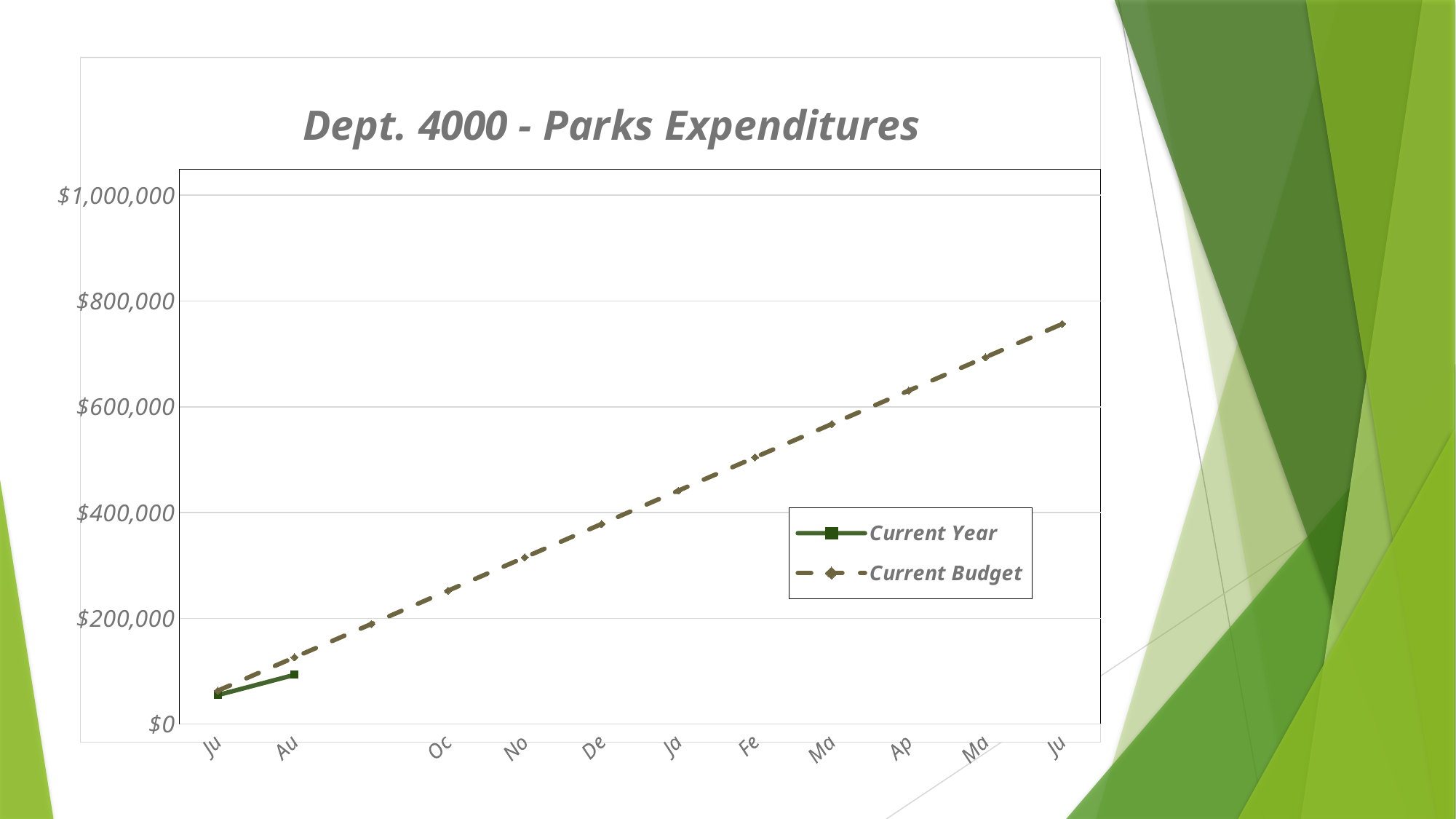
At which month does the Current Budget series reach its highest value? Ju (the last month on the x axis) What is the title of the chart? Dept. 4000 - Parks Expenditures Is the Current Budget value at the last month (Ju) greater or less than $600,000? greater Which series is drawn with a dashed line? Current Budget Is the Current Budget value for Ap greater or less than $600,000? greater Is the Current Budget value at the last month (Ju) greater or less than $800,000? less Does the Current Budget series rise or fall along the x axis? rise How many series does the legend list? 2 At Au, which series has the larger value, Current Year or Current Budget? Current Budget What kind of chart is shown on the slide? line chart